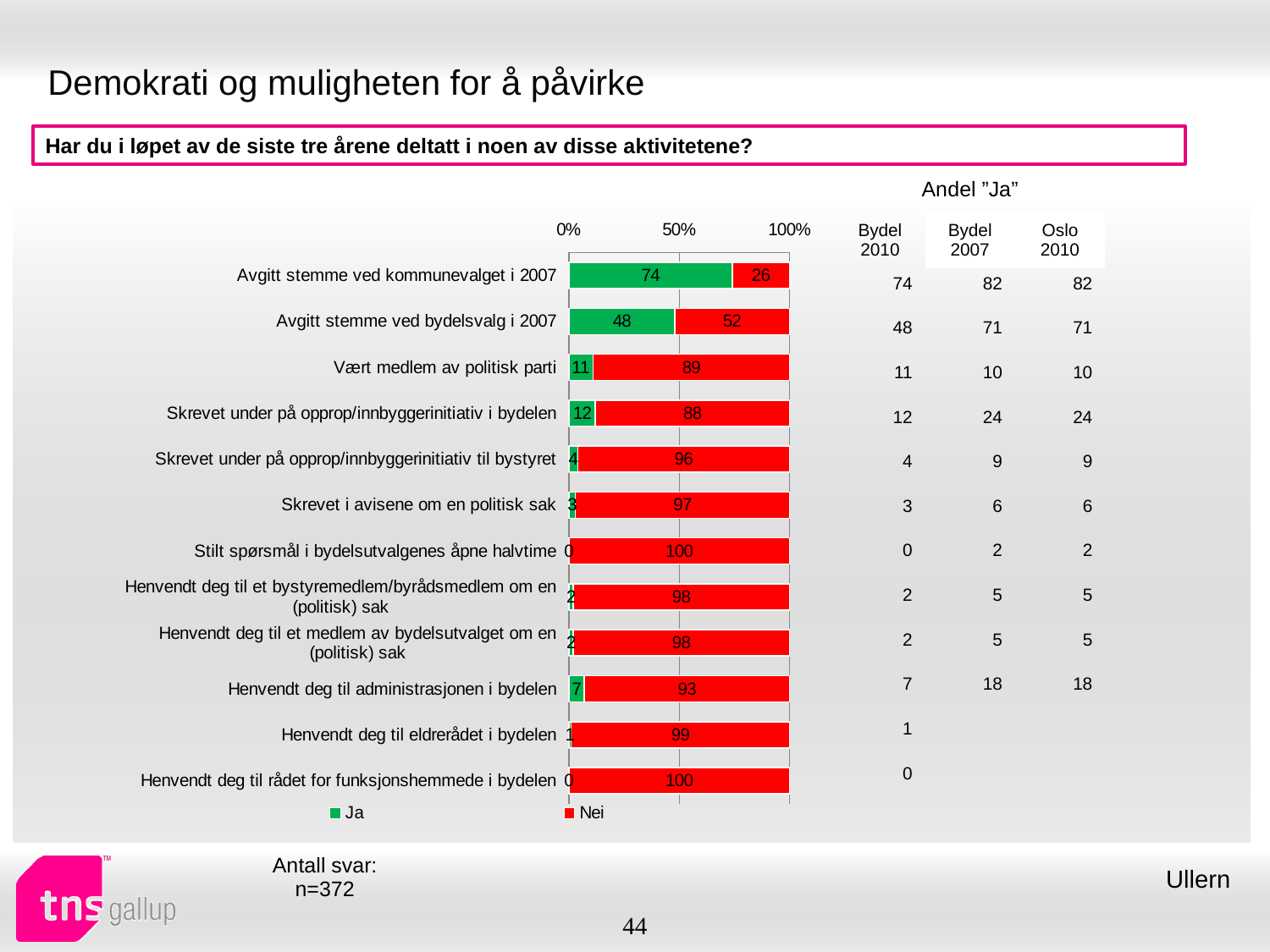
What is the "Nei" value for "Henvendt deg til administrasjonen i bydelen"? 93 What kind of chart is shown on the slide? Stacked bar chart What is the difference between the "Ja" value for "Avgitt stemme ved kommunevalget i 2007" and the "Ja" value for "Avgitt stemme ved bydelsvalg i 2007"? 26 Is the "Nei" value for "Vært medlem av politisk parti" greater or less than 50%? greater How many categories are shown in the bar chart? 12 What is the "Ja" value for "Avgitt stemme ved kommunevalget i 2007"? 74 How many series does the legend list? 2 What are the two legend entries of the chart? Ja and Nei What is the "Nei" value for "Avgitt stemme ved bydelsvalg i 2007"? 52 Which category has the highest "Ja" value? Avgitt stemme ved kommunevalget i 2007 What is the "Ja" value for "Skrevet i avisene om en politisk sak"? 3 Which has the larger "Ja" value: "Vært medlem av politisk parti" or "Skrevet under på opprop/innbyggerinitiativ i bydelen"? Skrevet under på opprop/innbyggerinitiativ i bydelen